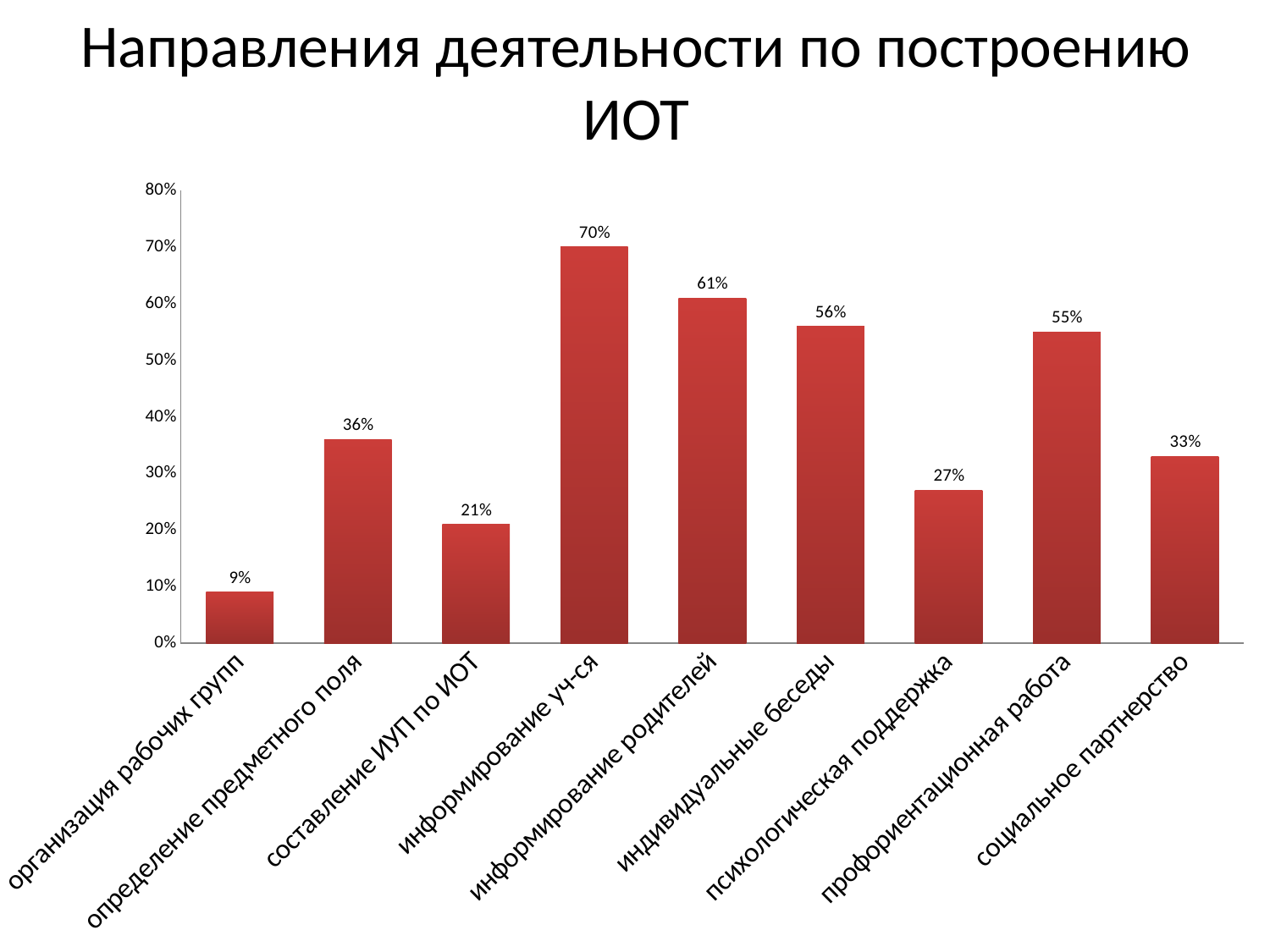
Is the value for индивидуальные беседы greater or less than 50%? greater How many categories are shown in the chart? 9 Which category has the highest value? информирование уч-ся What kind of chart is shown on the slide? bar chart What is the value for социальное партнерство? 33% What is the value for информирование уч-ся? 70% What is the difference between информирование родителей and индивидуальные беседы? 5% What is the title of the chart? Направления деятельности по построению ИОТ What is the difference between определение предметного поля and составление ИУП по ИОТ? 15% What is the value for психологическая поддержка? 27% Which category has the lowest value? организация рабочих групп Which is larger, профориентационная работа or социальное партнерство? профориентационная работа